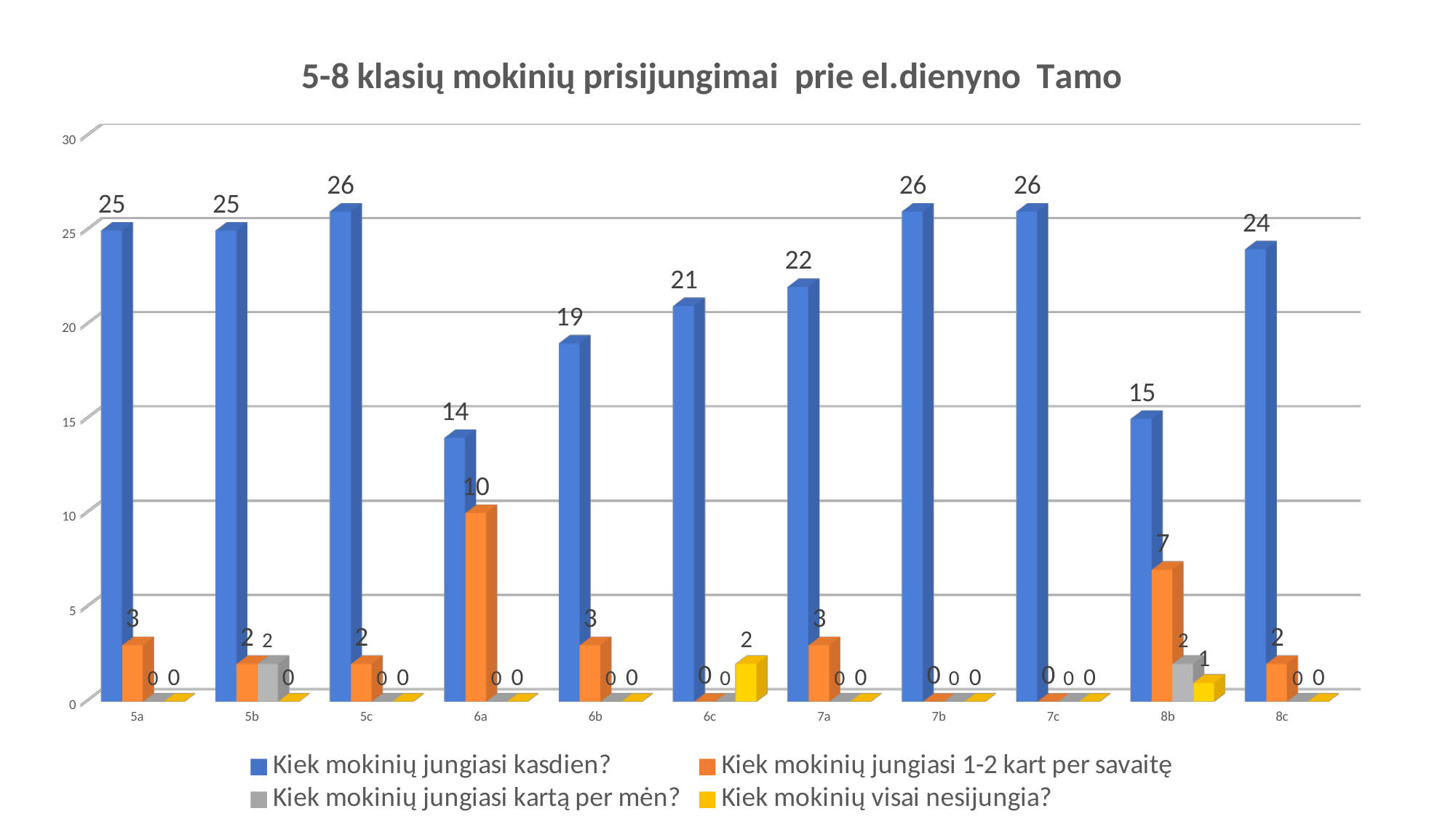
How many students in class 6a log in daily (Kiek mokinių jungiasi kasdien?)? 14 How many series does the legend list? 4 How many students in class 6c do not log in at all (Kiek mokinių visai nesijungia?)? 2 Which class has more students logging in daily, 6b or 7a? 7a What is the difference between the number of students logging in daily in class 8c and in class 8b? 9 What is the total number of students across all four series for class 8b? 25 What is the title of the chart? 5-8 klasių mokinių prisijungimai prie el.dienyno Tamo How many classes are shown on the x axis? 11 How many students in class 8b log in 1-2 times per week (Kiek mokinių jungiasi 1-2 kart per savaitę)? 7 Which class has the lowest number of students logging in daily? 6a What kind of chart is shown on the slide? Bar chart Which class has the highest number of students logging in 1-2 times per week? 6a